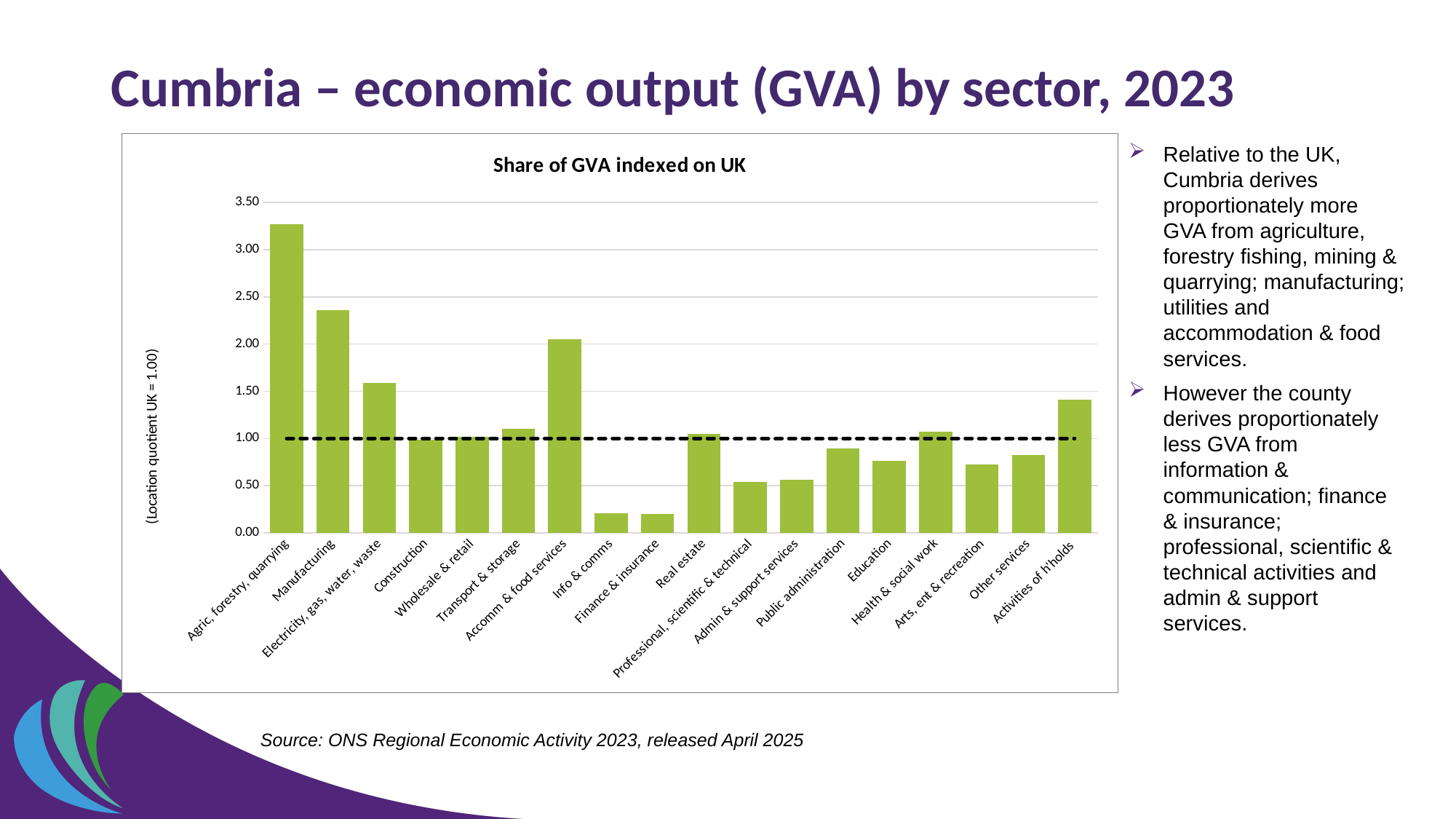
Which sector has the highest location quotient in the chart? Agric, forestry, quarrying Which is larger, the value for Manufacturing or the value for Accomm & food services? Manufacturing Is the value for Info & comms greater or less than 0.50? less Which is larger, the value for Electricity, gas, water, waste or the value for Activities of h'holds? Electricity, gas, water, waste What kind of chart is shown on the slide? bar chart Is the value for Activities of h'holds greater or less than 1.00? greater Is the value for Manufacturing greater or less than 2.00? greater What is the title of the chart? Share of GVA indexed on UK At what value on the y axis is the dashed horizontal reference line drawn? 1.00 How many sectors (bars) are plotted in the chart? 18